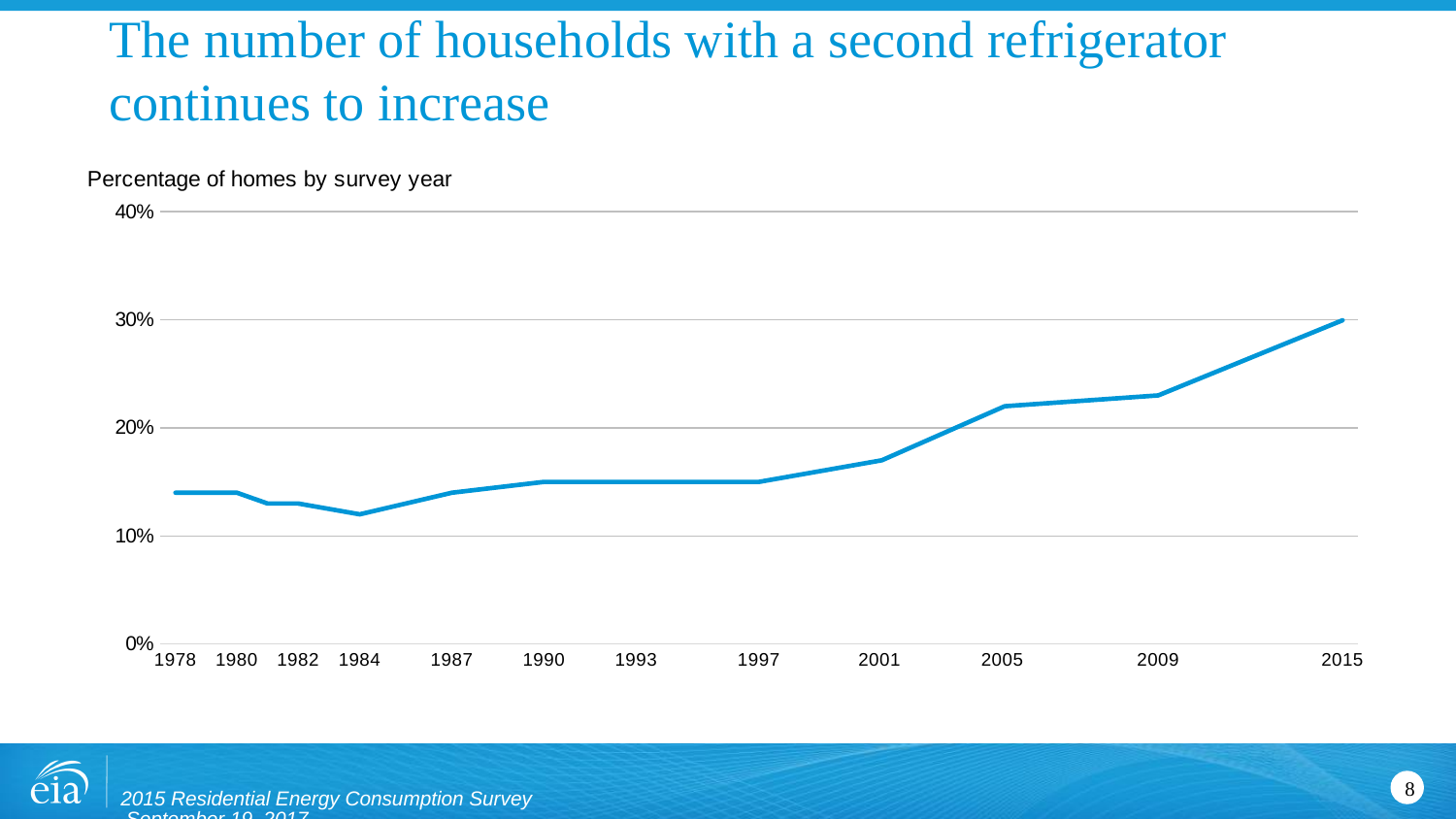
Which survey year has the highest percentage of homes with a second refrigerator? 2015 Is the value for 2009 greater or less than 30%? less Does the percentage of homes with a second refrigerator generally rise or fall from 1978 to 2015? rise Is the value for 1978 greater or less than 20%? less How many survey years are plotted on the x axis? 12 What is the subtitle shown above the chart? Percentage of homes by survey year Which is larger, the value for 2015 or the value for 1978? 2015 What kind of chart is shown on the slide? line chart Is the value for 2005 greater or less than 20%? greater Which survey year has the lowest percentage of homes with a second refrigerator? 1984